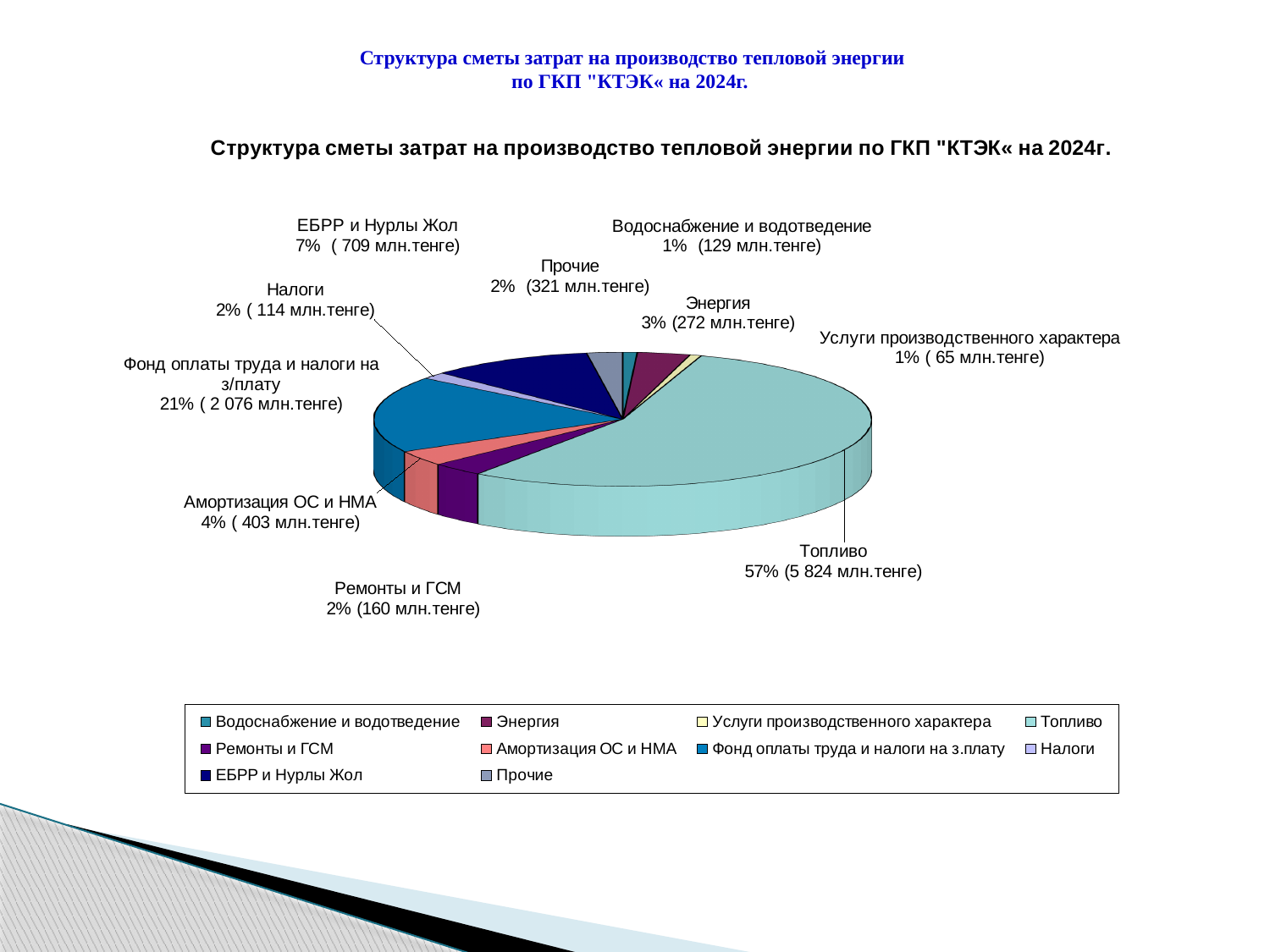
How many entries does the legend list? 10 What is the value in млн.тенге for Фонд оплаты труда и налоги на з/плату? 2 076 млн.тенге What kind of chart is shown on the slide? pie chart What share of the pie does Топливо account for? 57% What percentage share does ЕБРР и Нурлы Жол have? 7% What is the value in млн.тенге for Топливо? 5 824 млн.тенге What is the difference in млн.тенге between Топливо and Фонд оплаты труда и налоги на з/плату? 3 748 млн.тенге What is the value in млн.тенге for Амортизация ОС и НМА? 403 млн.тенге Which category has the smallest value in млн.тенге? Услуги производственного характера Which category has the largest share of the pie chart? Топливо Which is larger: ЕБРР и Нурлы Жол or Амортизация ОС и НМА? ЕБРР и Нурлы Жол How many categories (slices) does the pie chart have? 10